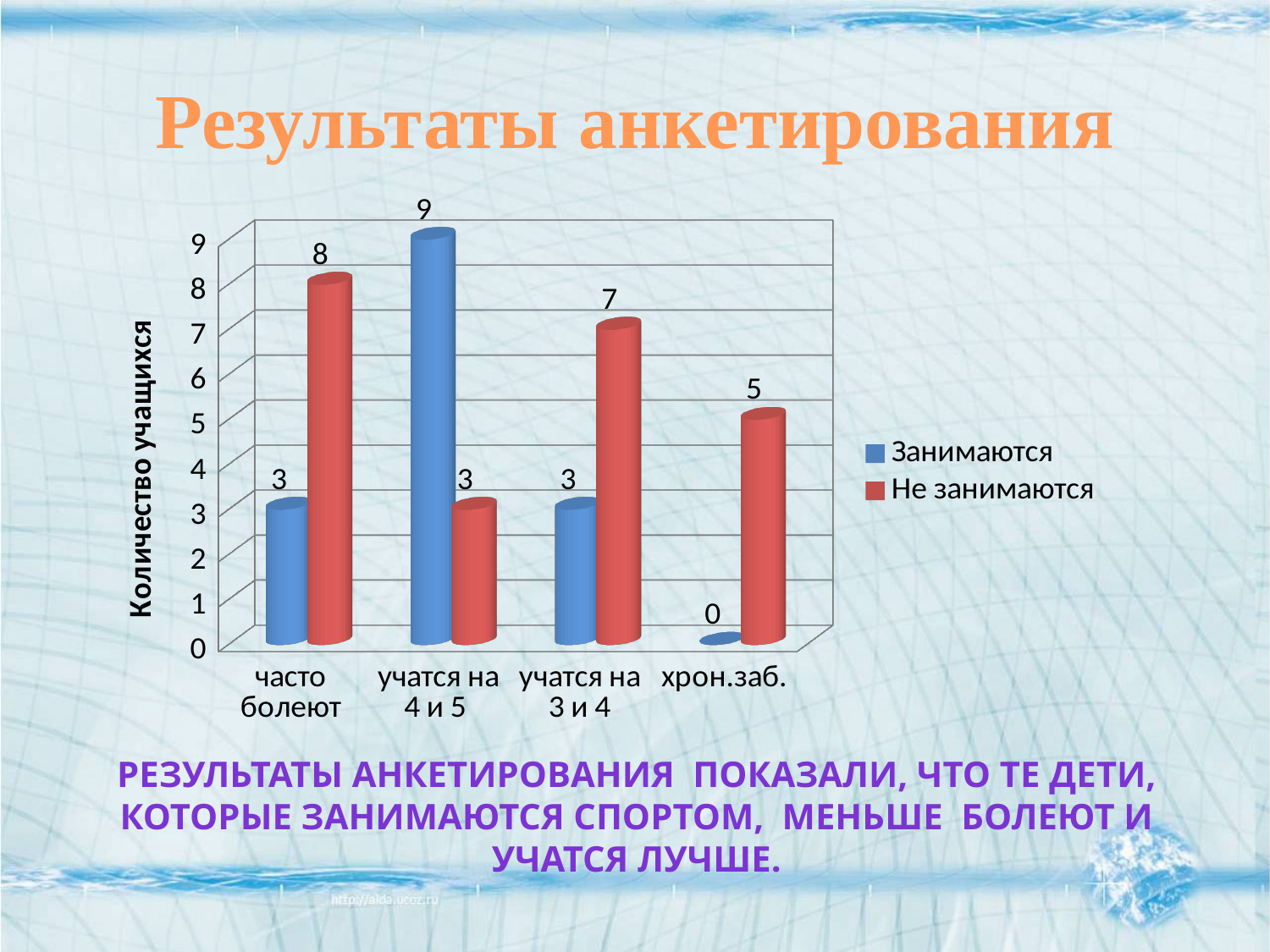
In the "учатся на 4 и 5" category, which series has the larger value? Занимаются What is the difference between "Не занимаются" and "Занимаются" in the "часто болеют" category? 5 What is the label of the vertical axis? Количество учащихся Which category has the highest value for the "Занимаются" series? учатся на 4 и 5 What kind of chart is shown on the slide? bar chart What is the value for "Не занимаются" in the "учатся на 3 и 4" category? 7 How many categories are shown on the x axis? 4 What is the value for "Занимаются" in the "хрон.заб." category? 0 What is the value for "Занимаются" in the "часто болеют" category? 3 How many series does the legend list? 2 Which category has the lowest value for the "Не занимаются" series? учатся на 4 и 5 What colour are the bars for the "Не занимаются" series? red